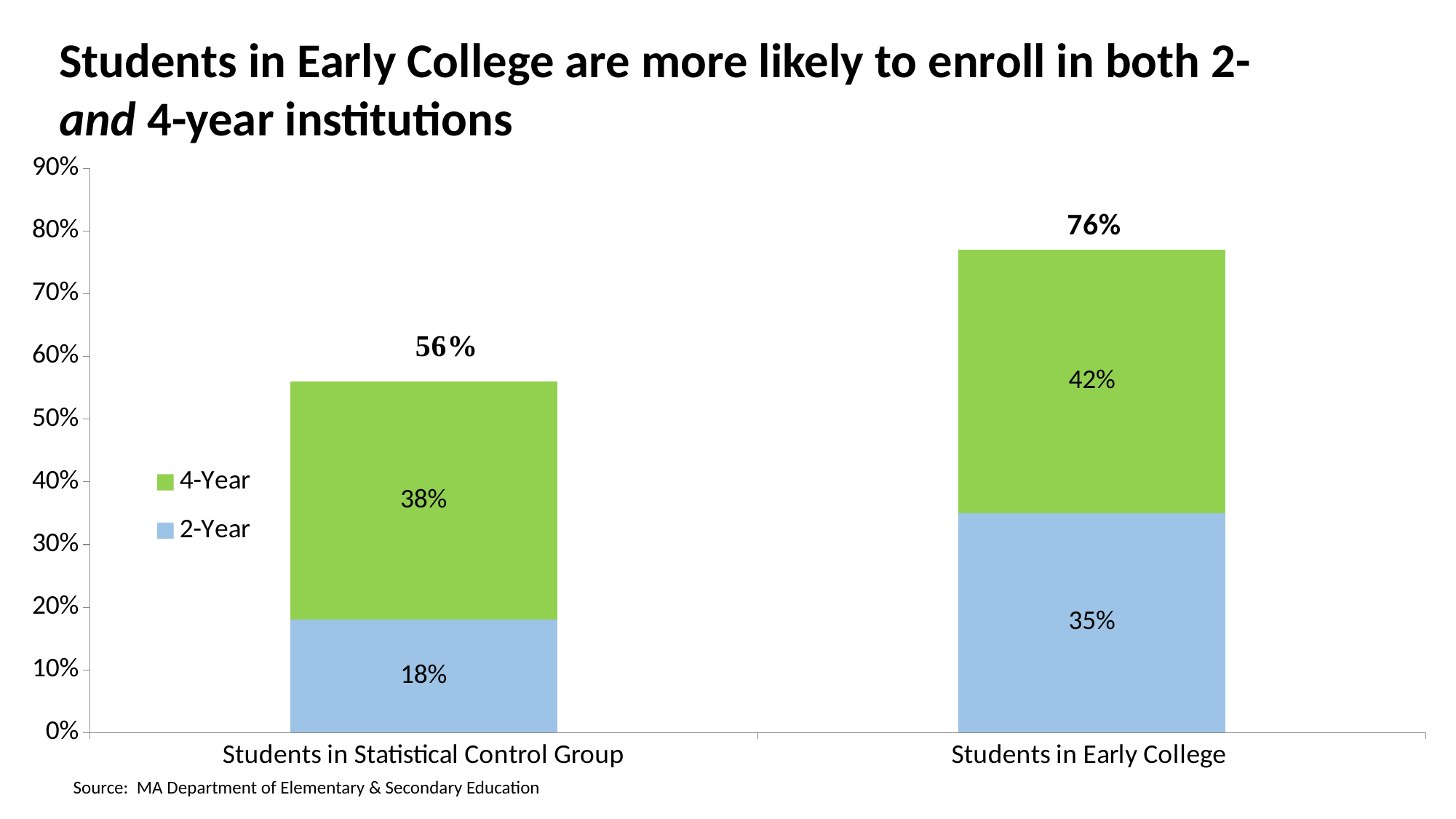
Which category has the higher total enrollment? Students in Early College How many categories are shown on the x axis? 2 What is the difference between the 2-Year values for Students in Early College and Students in Statistical Control Group? 17% What kind of chart is shown on the slide? Stacked bar chart What is the total of the stacked bar for Students in Statistical Control Group? 56% How many series does the legend list? 2 What is the 2-Year value for Students in Statistical Control Group? 18% What is the total of the stacked bar for Students in Early College? 76% What is the 2-Year value for Students in Early College? 35% What is the 4-Year value for Students in Early College? 42% What is the 4-Year value for Students in Statistical Control Group? 38% Which is larger: the 4-Year value for Students in Early College or the 4-Year value for Students in Statistical Control Group? Students in Early College